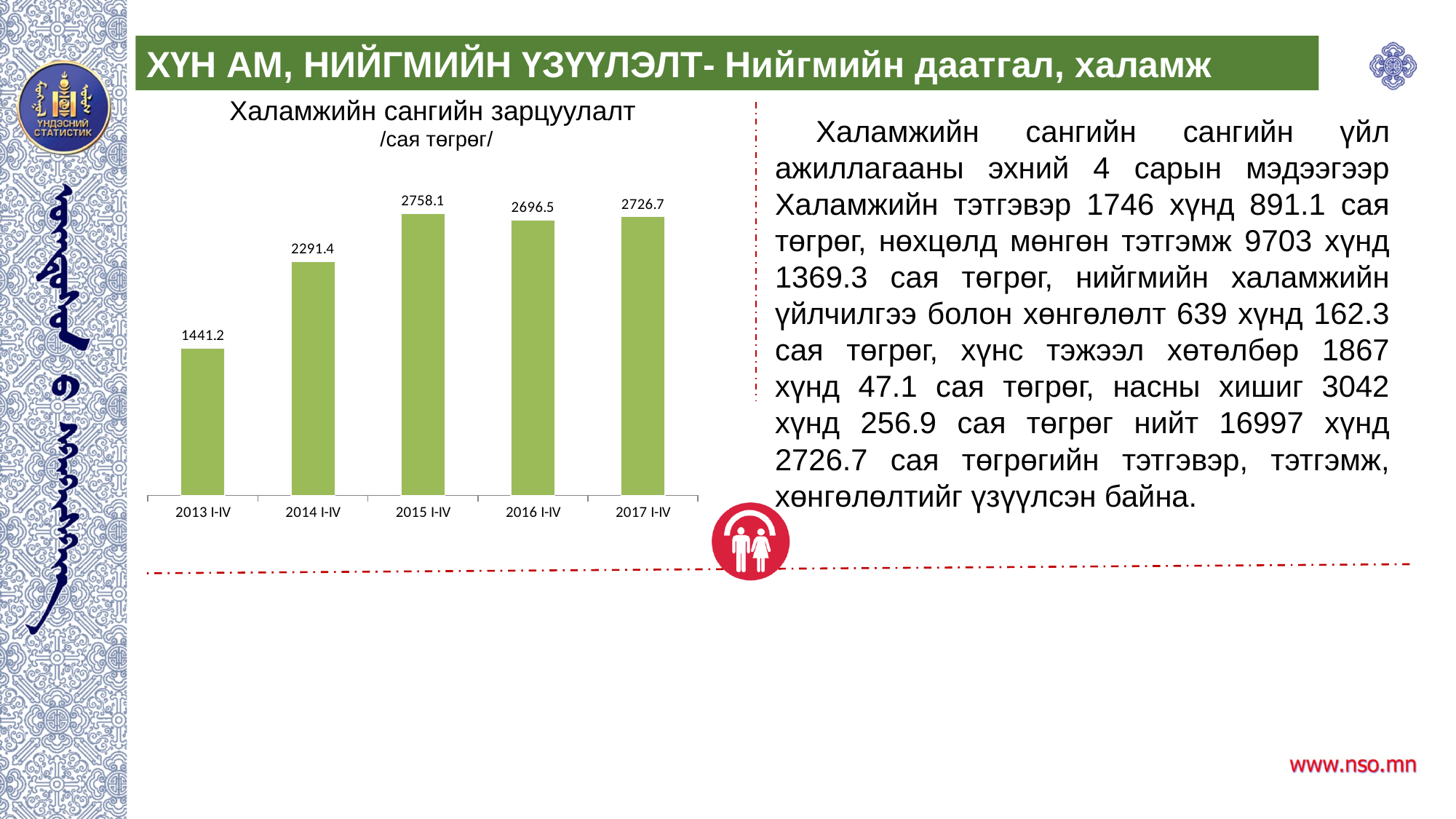
Which period has the lowest value in the chart? 2013 I-IV Which is larger, the value for 2016 I-IV or the value for 2017 I-IV? 2017 I-IV What is the value for 2013 I-IV in the chart 'Халамжийн сангийн зарцуулалт'? 1441.2 What is the difference between the values for 2017 I-IV and 2016 I-IV? 30.2 What is the value for 2015 I-IV in the chart? 2758.1 How many periods (bars) are shown in the chart? 5 What is the value for 2017 I-IV in the chart? 2726.7 Which period has the highest value in the chart? 2015 I-IV What unit is given under the chart title? сая төгрөг Do the values rise or fall from 2013 I-IV to 2015 I-IV? Rise What is the difference between the values for 2015 I-IV and 2013 I-IV? 1316.9 What kind of chart is shown on the slide? Bar chart